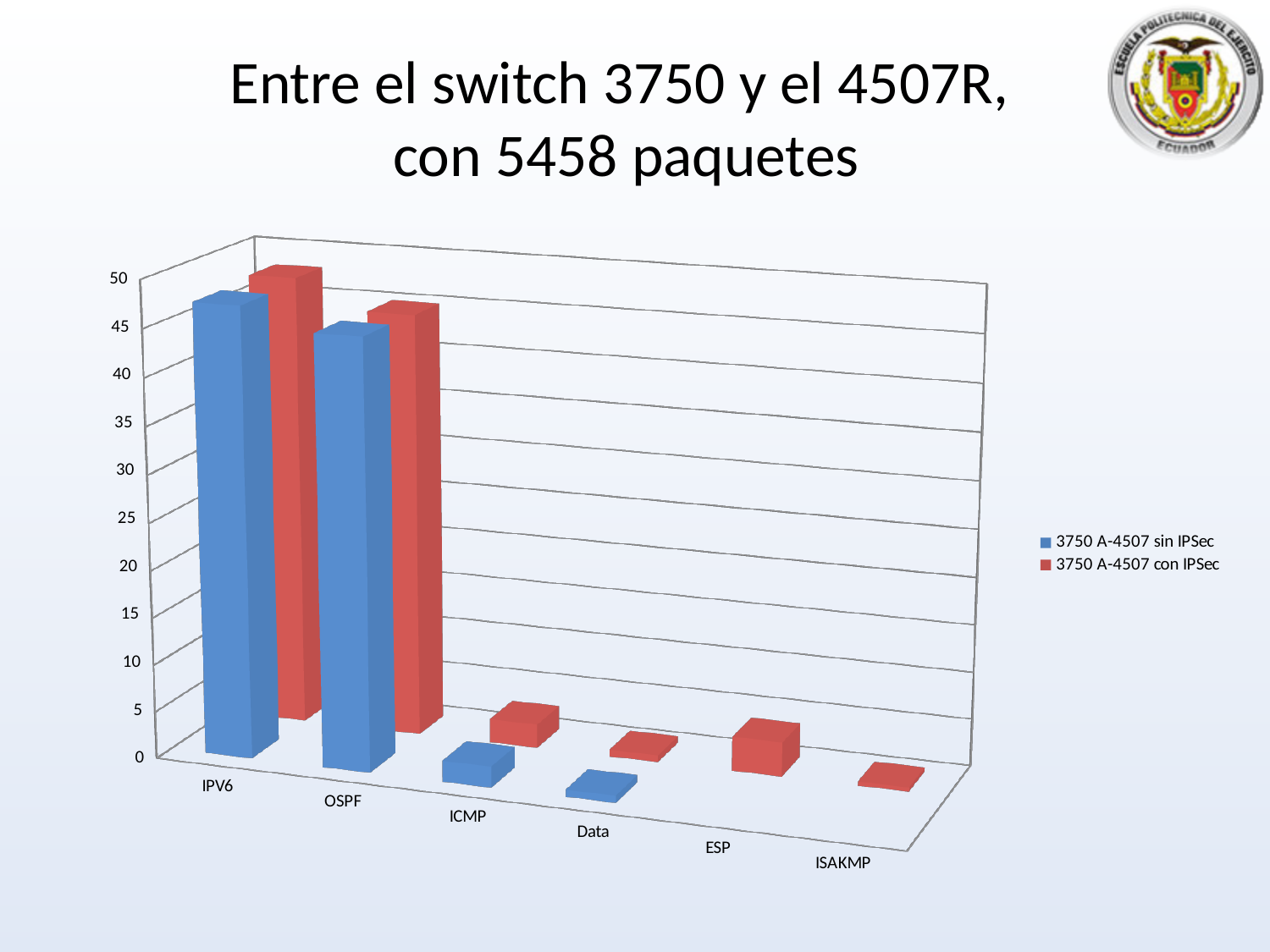
Which category has the highest value for the series '3750 A-4507 sin IPSec'? IPV6 How many categories are shown on the x axis of the chart? 6 Is the value for OSPF in the series '3750 A-4507 con IPSec' greater or less than 40? greater For the series '3750 A-4507 sin IPSec', which is larger: IPV6 or OSPF? IPV6 What kind of chart is shown on the slide? Bar chart How many series does the chart's legend list? 2 Which category has the highest value for the series '3750 A-4507 con IPSec'? IPV6 Is the value for ICMP in the series '3750 A-4507 con IPSec' greater or less than 10? less Is the value for ESP in the series '3750 A-4507 con IPSec' greater or less than 10? less Which colour represents the series '3750 A-4507 con IPSec' in the chart? Red What is the title of the slide containing the chart? Entre el switch 3750 y el 4507R, con 5458 paquetes